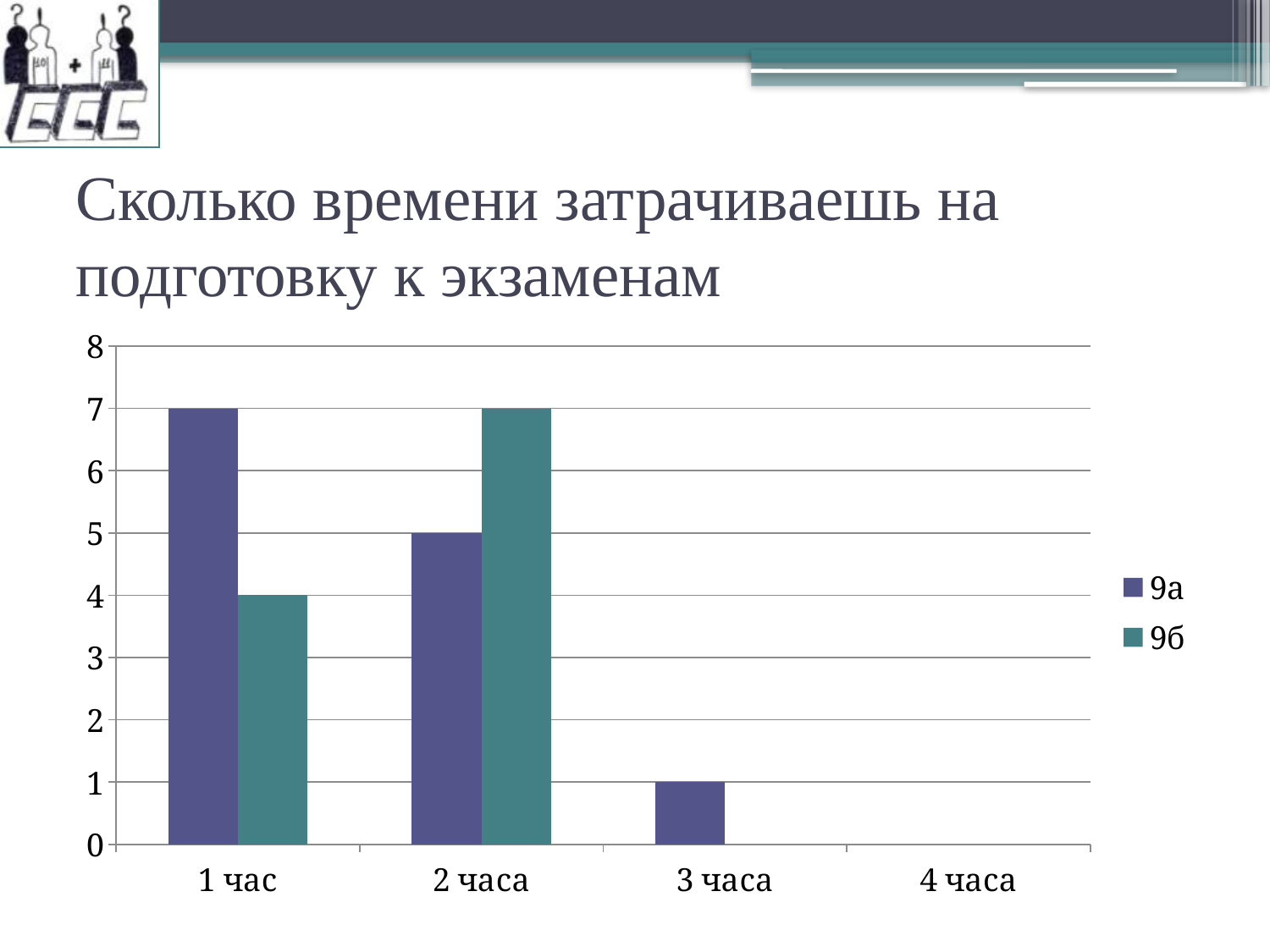
What is the value for 9а at 3 часа? 1 What is the difference between the 9а and 9б values at 1 час? 3 What is the value for 9б at 1 час? 4 Which category has the highest value for series 9а? 1 час How many categories are shown on the x axis? 4 How many series does the legend list? 2 Which series has the larger value at 2 часа, 9а or 9б? 9б Which category has the highest value for series 9б? 2 часа What is the value for 9б at 2 часа? 7 What is the value for 9а at 1 час? 7 What is the value for 9а at 2 часа? 5 What kind of chart is shown on the slide? bar chart